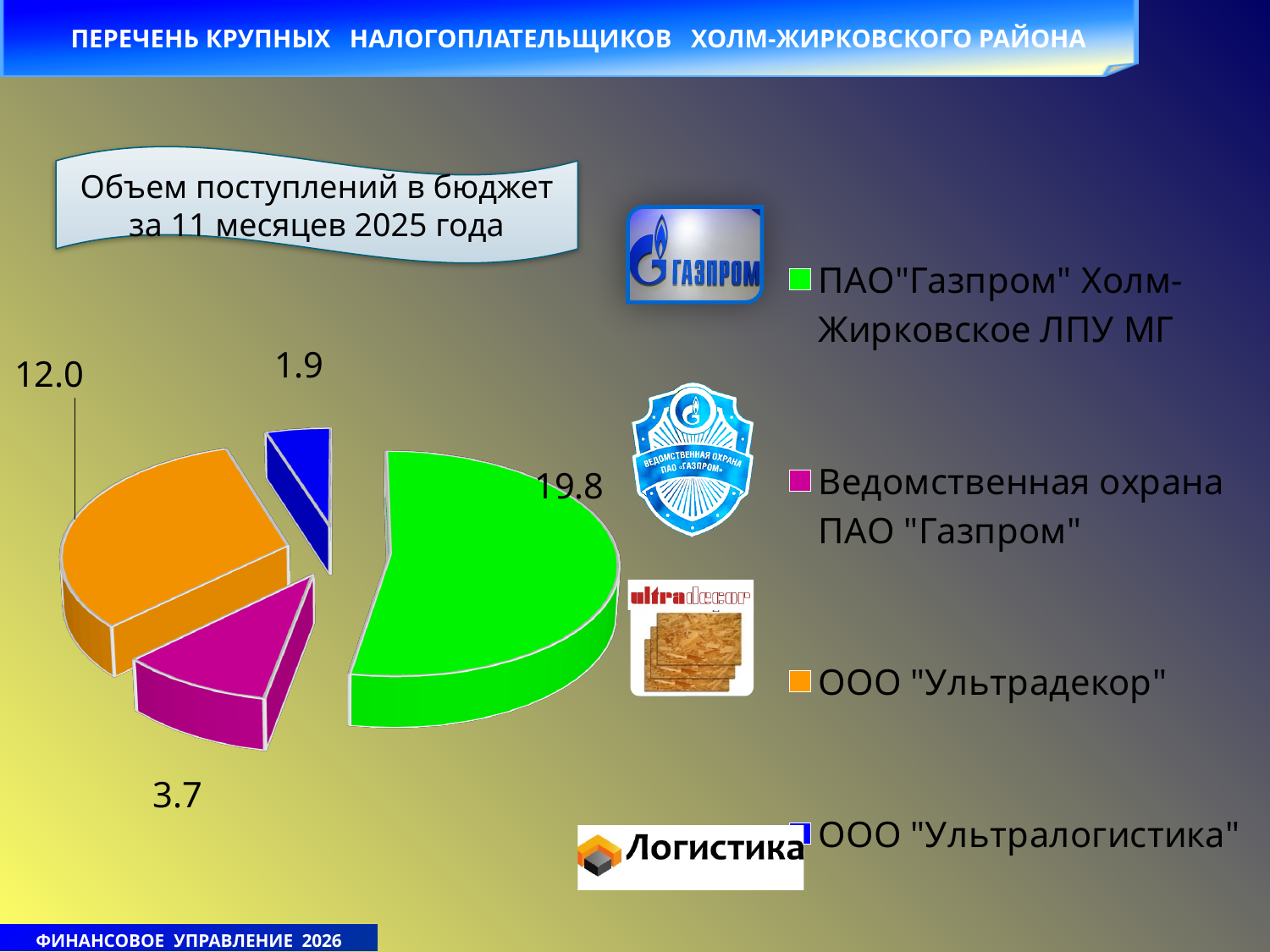
What is the difference between the values for ПАО "Газпром" Холм-Жирковское ЛПУ МГ and ООО "Ультрадекор"? 7.8 What is the value for Ведомственная охрана ПАО "Газпром"? 3.7 What is the value for ПАО "Газпром" Холм-Жирковское ЛПУ МГ? 19.8 How many slices does the pie chart have? 4 What is the value for ООО "Ультрадекор"? 12.0 What kind of chart is shown on the slide? Pie chart Which category has the largest slice of the pie? ПАО "Газпром" Холм-Жирковское ЛПУ МГ What period does the chart's caption say the budget receipts cover? 11 месяцев 2025 года Which is larger: the value for ООО "Ультрадекор" or the value for Ведомственная охрана ПАО "Газпром"? ООО "Ультрадекор" What is the value for ООО "Ультралогистика"? 1.9 Which category has the smallest slice of the pie? ООО "Ультралогистика" What colour is the slice for ООО "Ультрадекор"? Orange